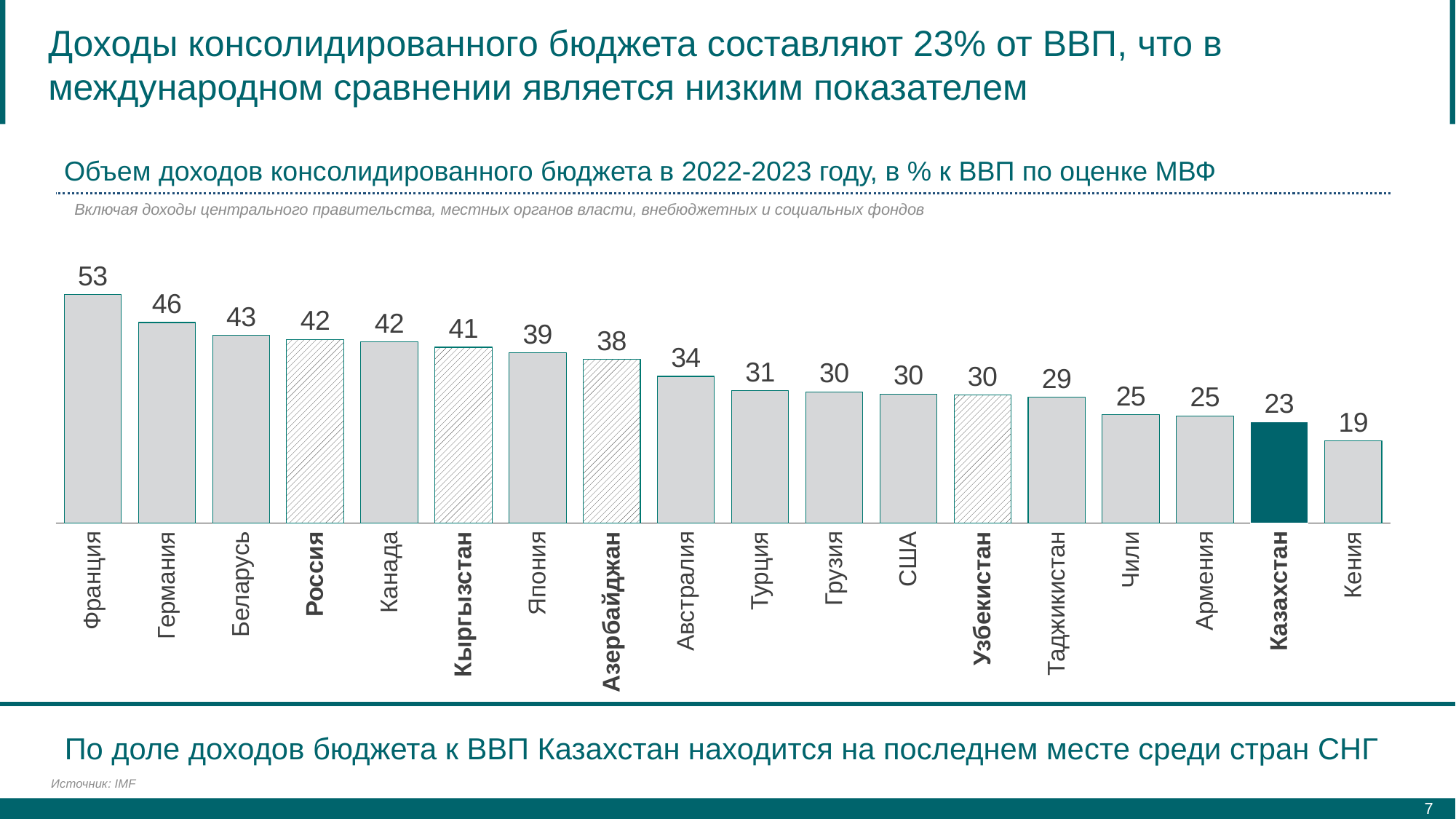
What is the difference between the values for Россия and Кения? 23 Which country has the lowest value? Кения What is the value for Франция? 53 Which country has the highest value? Франция What is the value for Азербайджан? 38 Which is larger, the value for Япония or the value for Австралия? Япония What is the difference between the values for Германия and Казахстан? 23 What kind of chart is shown on the slide? Bar chart How many countries are shown in the chart? 18 Which is larger, the value for Таджикистан or the value for Чили? Таджикистан Do the values rise or fall from left to right along the x axis? Fall What is the value for Казахстан? 23